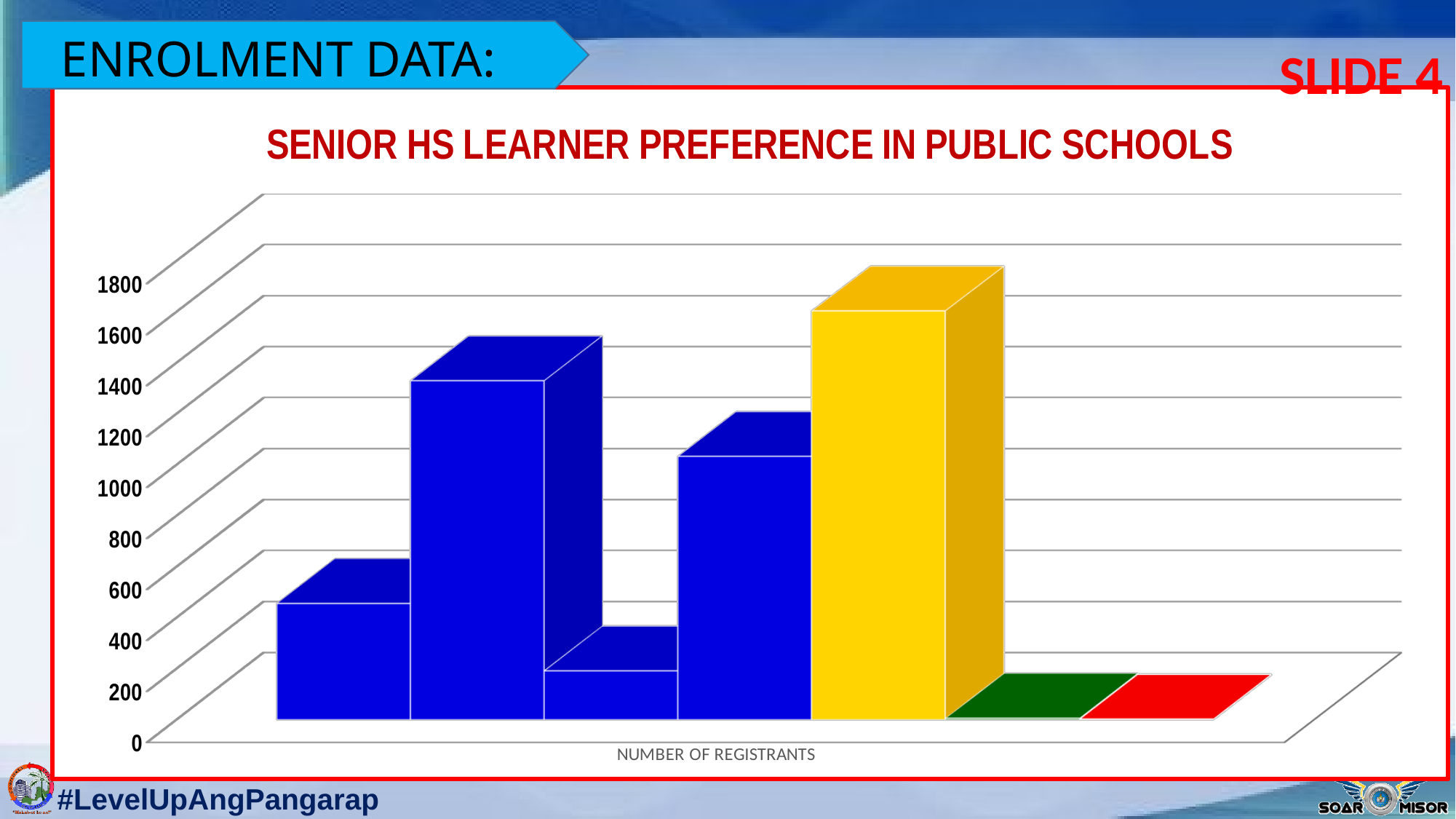
Which is larger, the second bar from the left or the fourth bar from the left? the second bar from the left Is the value of the red bar greater or less than 200? less What label appears under the horizontal axis of the chart? NUMBER OF REGISTRANTS How many bars are plotted in the chart? 7 Is the value of the first (leftmost) blue bar greater or less than 400? greater Is the value of the third bar from the left greater or less than 400? less What is the title of the chart? SENIOR HS LEARNER PREFERENCE IN PUBLIC SCHOOLS Which bar is the tallest in the chart? the yellow bar (fifth from the left) What kind of chart is shown on the slide? bar chart